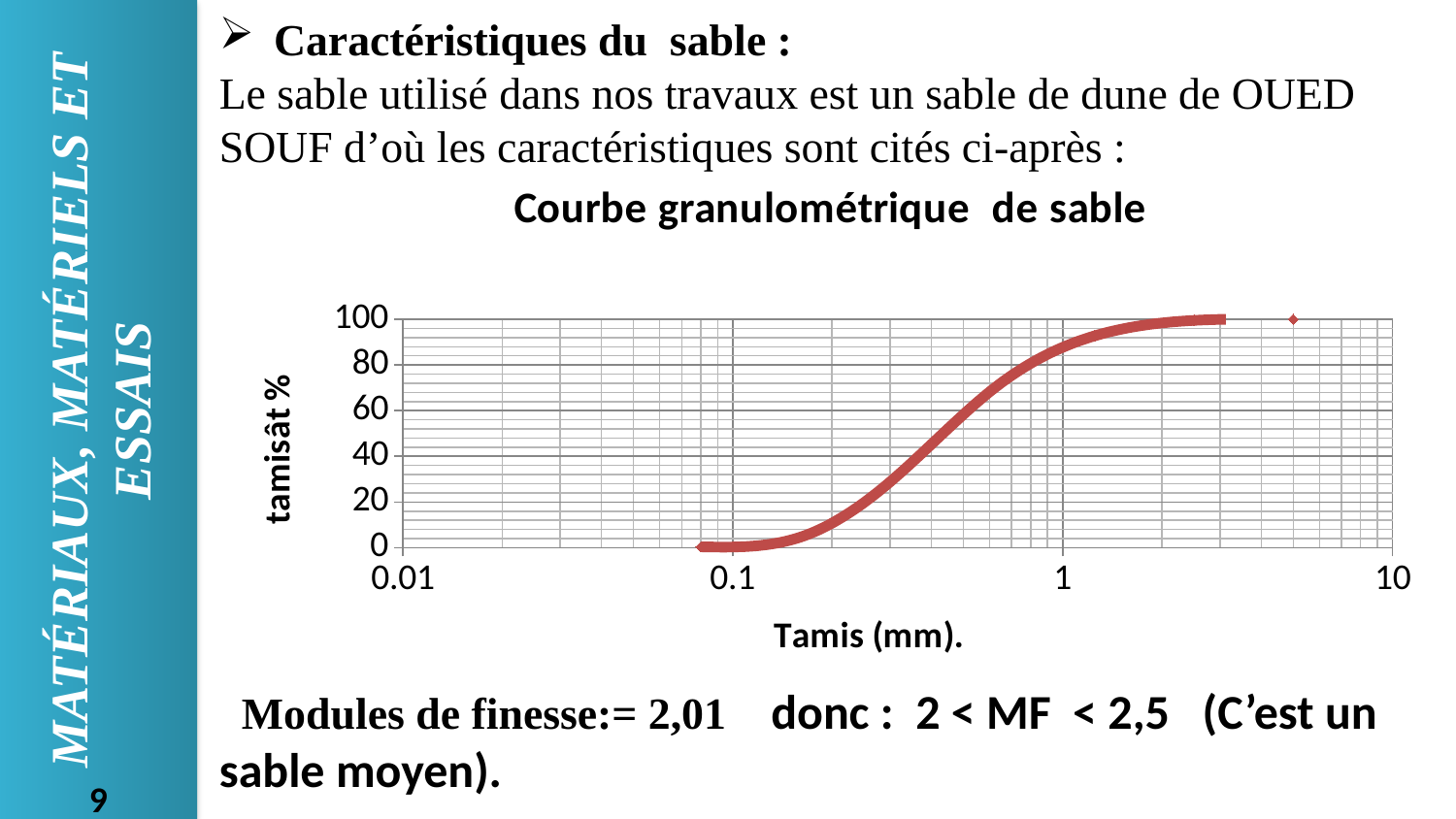
What is the label of the x axis of the chart? Tamis (mm). Is the tamisât % value at a sieve size of 1 mm larger or smaller than the value at 0.1 mm? larger What kind of chart is shown on the slide? line chart Is the tamisât % value at a sieve size of 0.1 mm greater or less than 20? less What is the title of the chart? Courbe granulométrique de sable Is the tamisât % value at a sieve size of 0.2 mm greater or less than 40? less What is the highest tamisât % value reached by the curve? 100 Is the tamisât % value at a sieve size of 2 mm greater or less than 80? greater Do the tamisât % values rise or fall as the sieve size (Tamis) increases along the x axis? rise